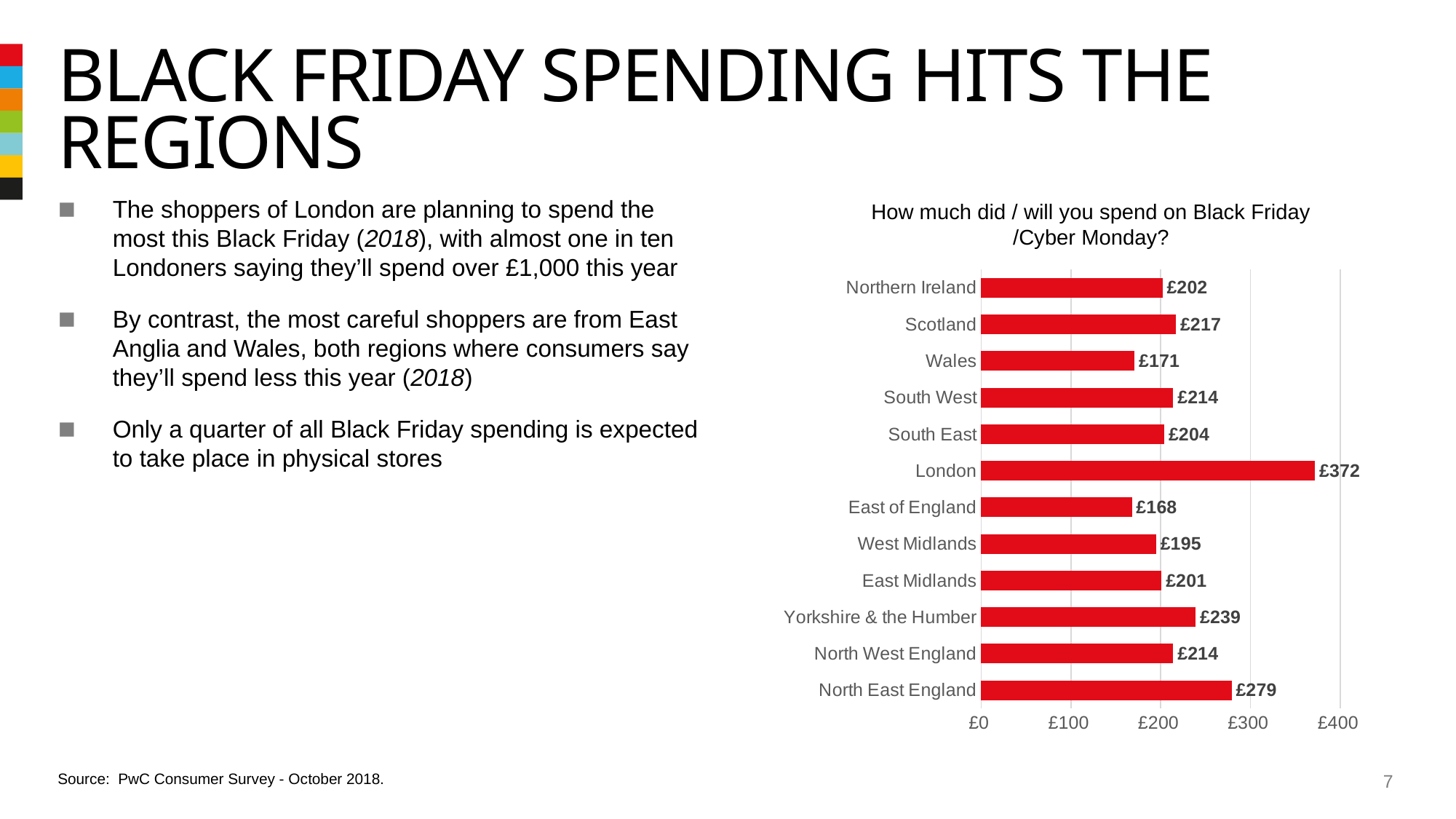
What is the difference between the values for London and North East England? £93 What is the title of the chart? How much did / will you spend on Black Friday /Cyber Monday? Is the value for North East England greater or less than £200? greater What is the value for London? £372 Which is larger, the value for Scotland or the value for Northern Ireland? Scotland How many regions are shown in the chart? 12 Which region has the highest value? London What kind of chart is shown on the slide? Bar chart What is the value for Wales? £171 What colour are the bars in the chart? Red Which region has the lowest value? East of England What is the value for Yorkshire & the Humber? £239